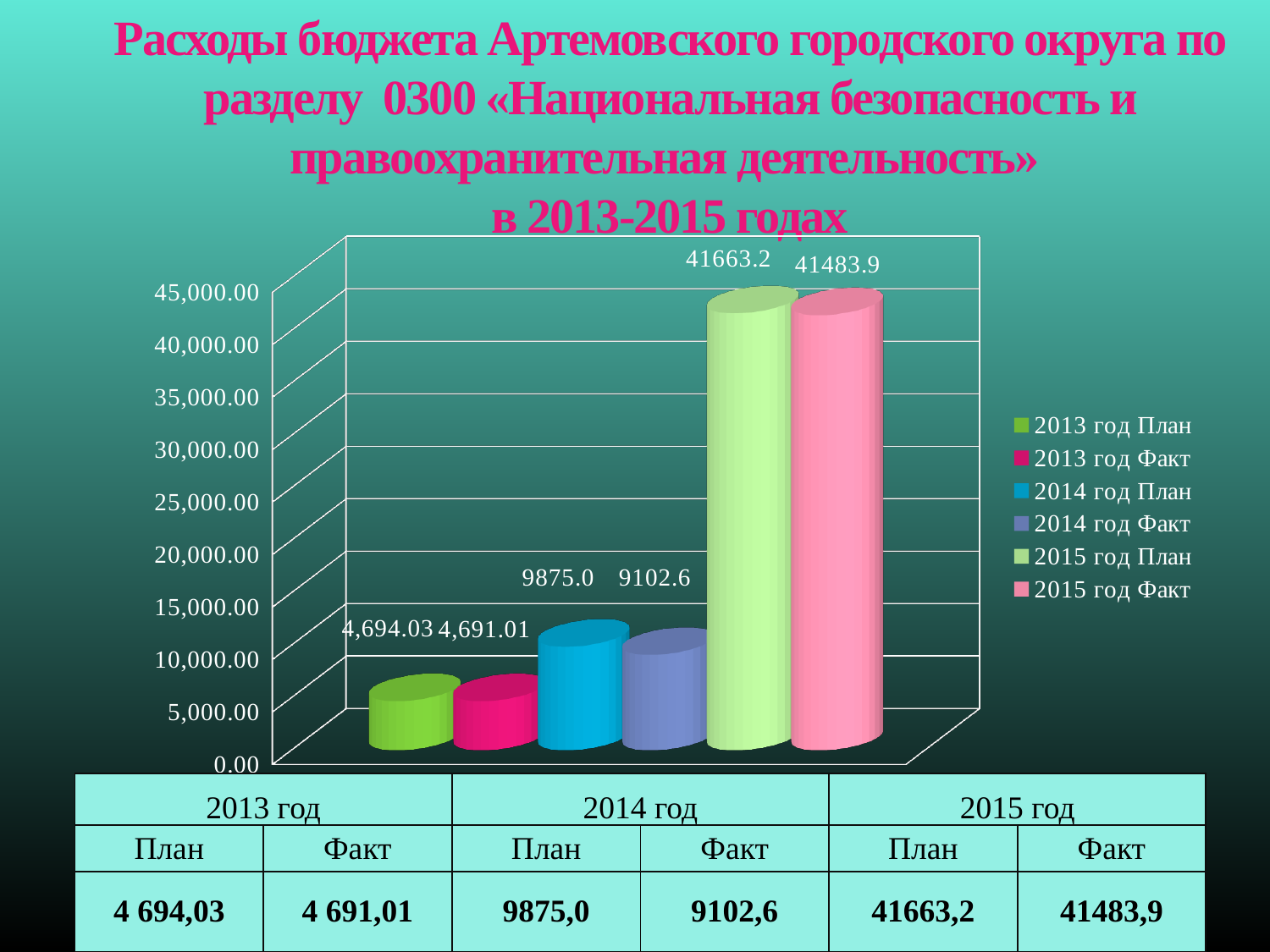
What is the value for 2014 год Факт? 9102.6 How many series does the legend list? 6 What is the difference between 2014 год План and 2014 год Факт? 772.4 Which series has the highest value? 2015 год План What is the difference between 2015 год План and 2015 год Факт? 179.3 What is the value for 2013 год План? 4,694.03 What kind of chart is shown on the slide? bar chart What is the value for 2015 год План? 41663.2 Which is larger, 2014 год План or 2014 год Факт? 2014 год План Is the value for 2014 год План greater or less than 10,000.00? less What is the value for 2015 год Факт? 41483.9 Which series has the lowest value? 2013 год Факт